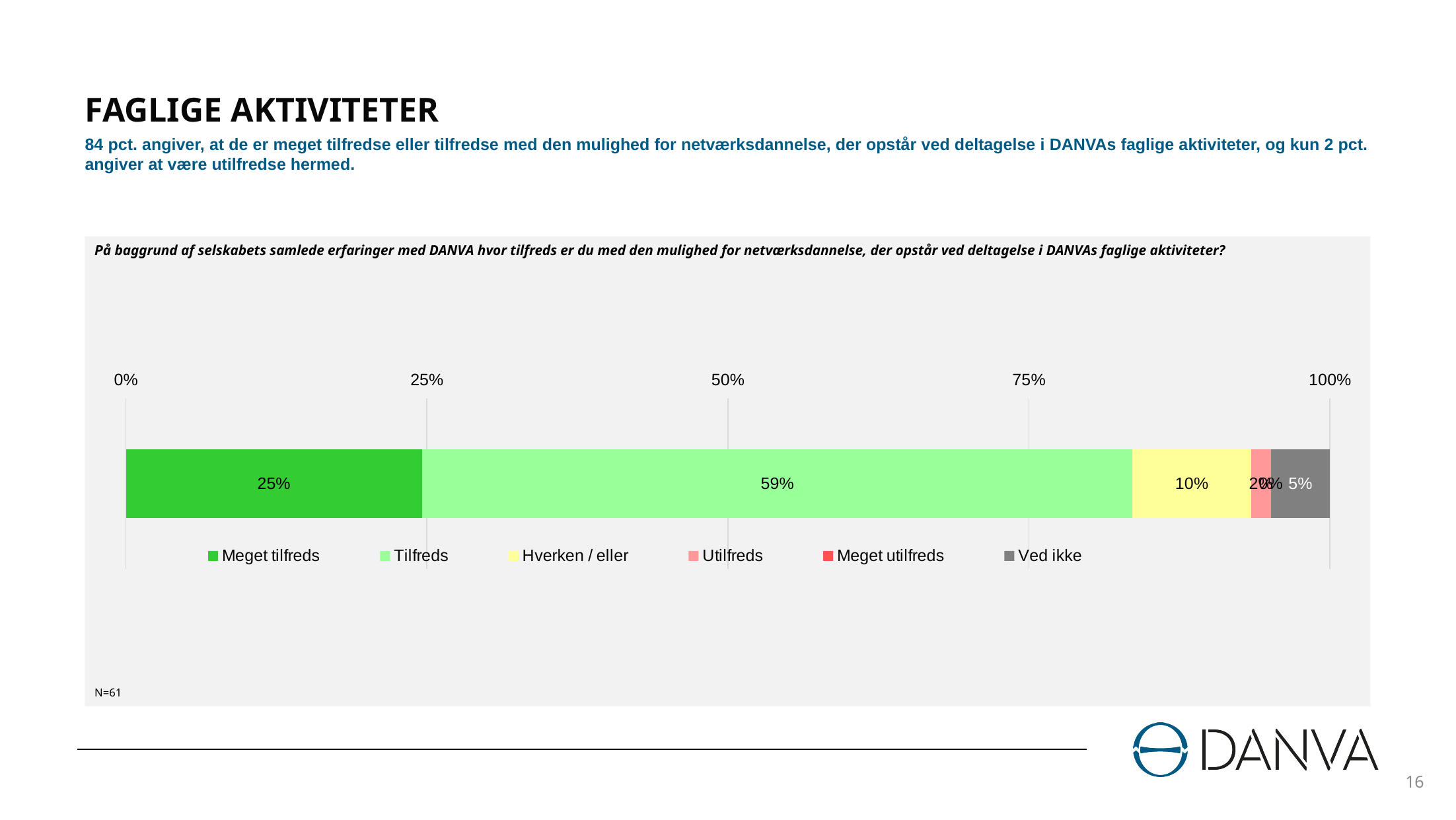
Which is larger, the share for "Meget tilfreds" or the share for "Hverken / eller"? Meget tilfreds What colour represents "Ved ikke" in the chart? Grey What kind of chart is shown on the slide? Stacked horizontal bar chart How many percentage points larger is the "Tilfreds" share than the "Meget tilfreds" share? 34 percentage points What percentage of respondents answered "Tilfreds"? 59% What is the sample size (N) stated for the chart? N=61 What is the value shown for "Ved ikke"? 5% Which response category has the largest share of the bar? Tilfreds What percentage of respondents answered "Meget tilfreds"? 25% Is the value for "Tilfreds" greater or less than 50%? greater What is the value shown for "Hverken / eller"? 10% How many response categories does the legend list? 6